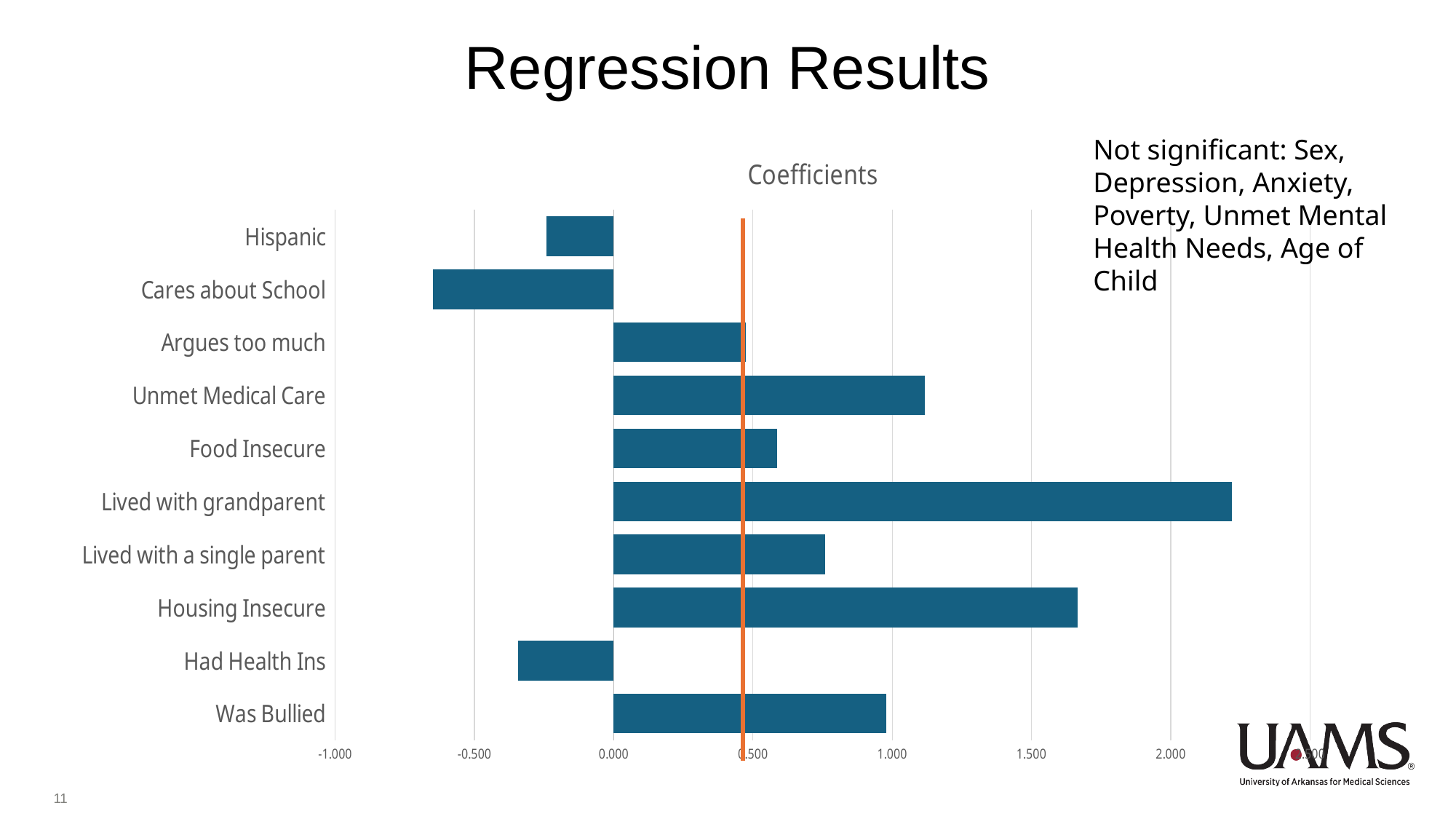
Which has the larger coefficient, Housing Insecure or Unmet Medical Care? Housing Insecure Is the value for Lived with grandparent greater or less than 2.000? greater How many categories have a negative coefficient? 3 Which has the larger coefficient, Lived with a single parent or Food Insecure? Lived with a single parent Is the value for Housing Insecure greater or less than 1.500? greater Which category has the lowest coefficient? Cares about School Which category has the highest coefficient? Lived with grandparent Is the value for Had Health Ins greater or less than 0.000? less What is the title of the chart? Coefficients What kind of chart is shown on the slide? bar chart How many categories are plotted in the chart? 10